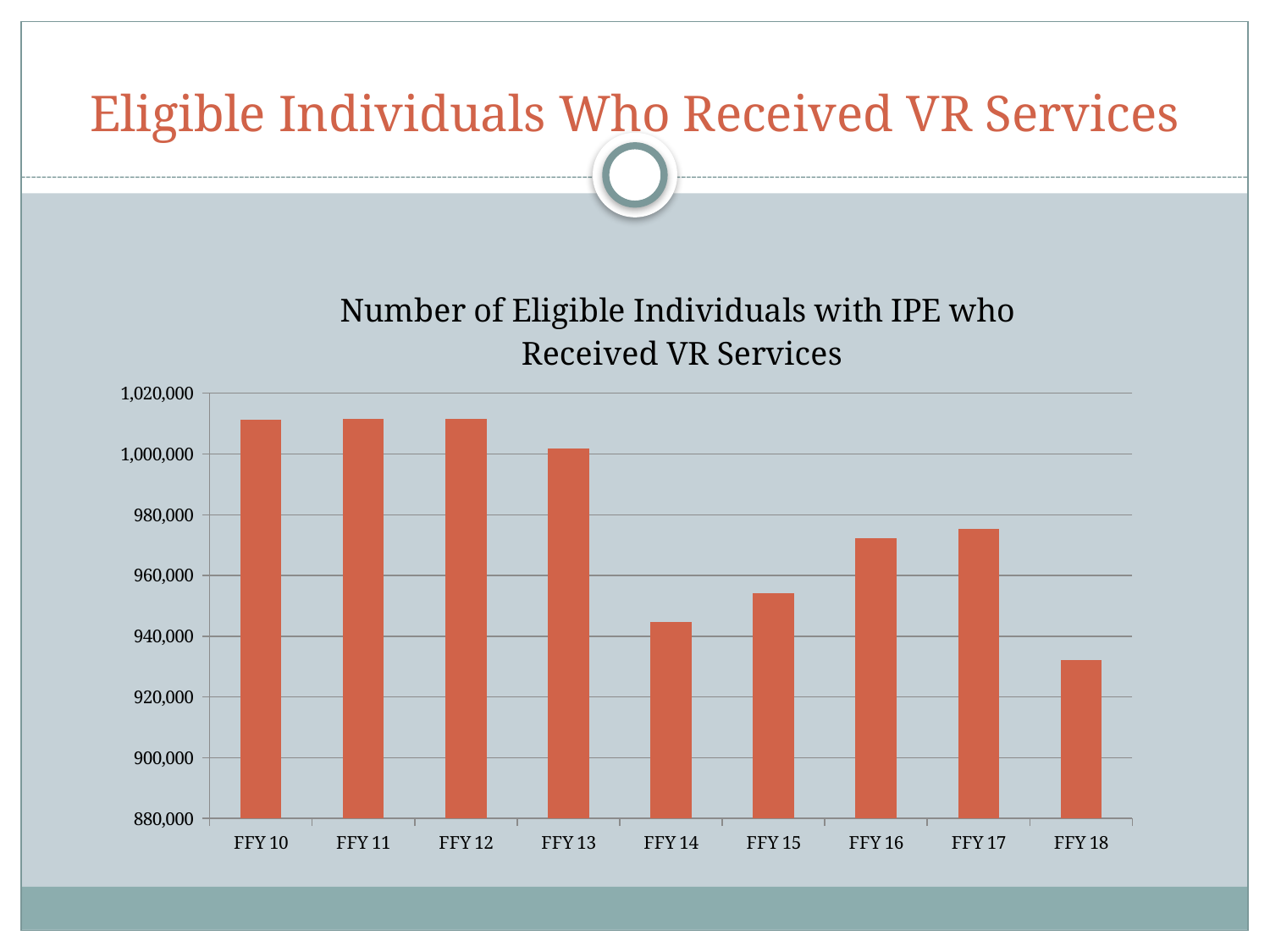
From FFY 14 to FFY 17, do the values rise or fall? rise How many fiscal years are plotted on the chart? 9 Is the value for FFY 17 greater or less than 960,000? greater Is the value for FFY 14 greater or less than 960,000? less Which is larger, the value for FFY 13 or the value for FFY 14? FFY 13 What kind of chart is shown on the slide? bar chart Which is larger, the value for FFY 16 or the value for FFY 18? FFY 16 Is the value for FFY 18 greater or less than 940,000? less Which fiscal year has the lowest number of eligible individuals who received VR services? FFY 18 What is the title of the chart? Number of Eligible Individuals with IPE who Received VR Services